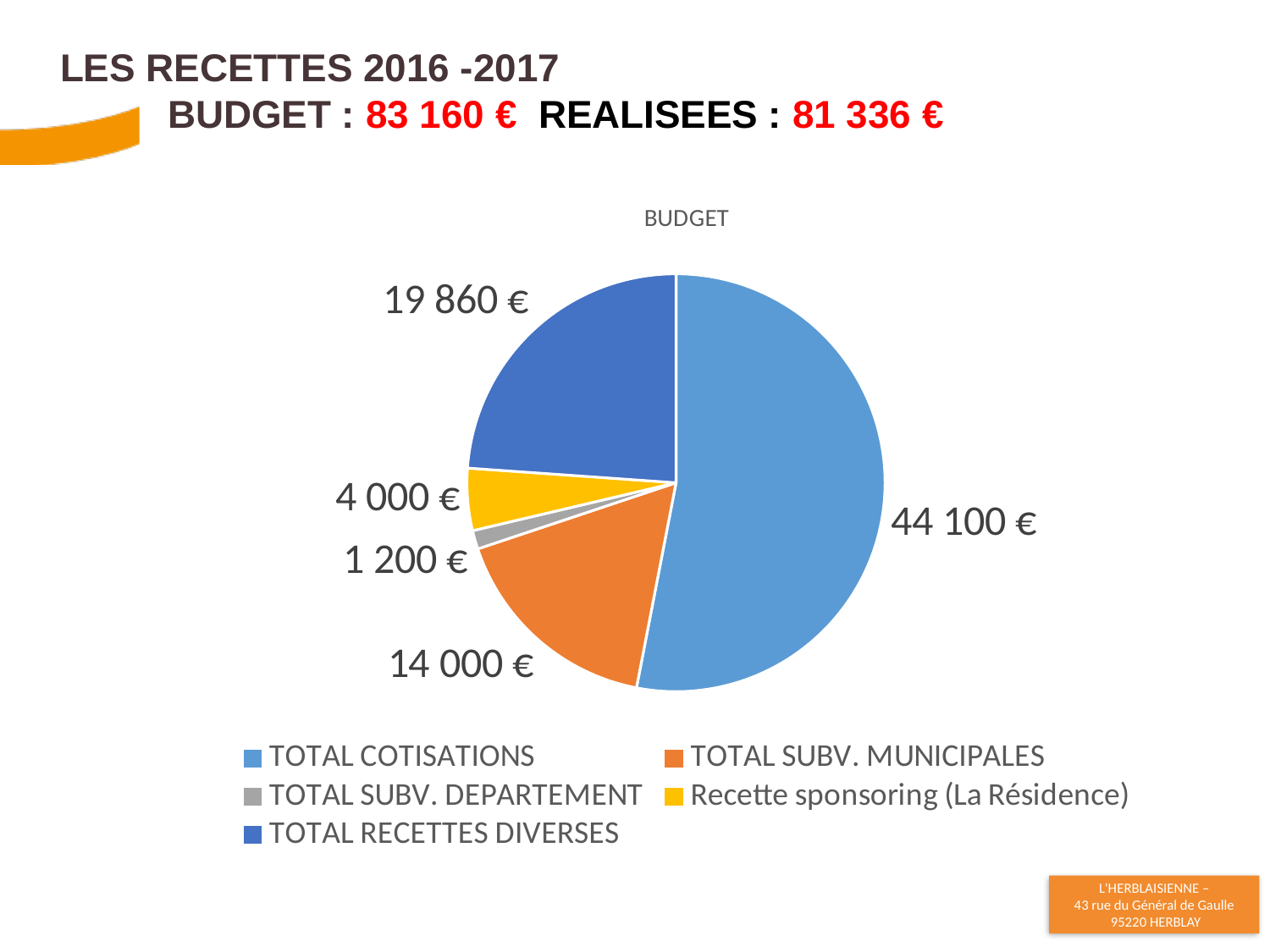
What is the value of the TOTAL RECETTES DIVERSES slice in the BUDGET pie chart? 19 860 € Which category has the smallest slice in the BUDGET pie chart? TOTAL SUBV. DEPARTEMENT What is the value of the Recette sponsoring (La Résidence) slice in the BUDGET pie chart? 4 000 € Which is larger in the BUDGET pie chart: TOTAL SUBV. MUNICIPALES or TOTAL RECETTES DIVERSES? TOTAL RECETTES DIVERSES What type of chart is shown on the slide? Pie chart What is the value of the TOTAL COTISATIONS slice in the BUDGET pie chart? 44 100 € What is the difference between TOTAL COTISATIONS and TOTAL SUBV. MUNICIPALES in the BUDGET pie chart? 30 100 € What colour is the TOTAL SUBV. DEPARTEMENT slice in the BUDGET pie chart? Grey How many slices does the BUDGET pie chart have? 5 Which category has the largest slice in the BUDGET pie chart? TOTAL COTISATIONS What is the value of the TOTAL SUBV. MUNICIPALES slice in the BUDGET pie chart? 14 000 € What is the difference between TOTAL RECETTES DIVERSES and Recette sponsoring (La Résidence) in the BUDGET pie chart? 15 860 €